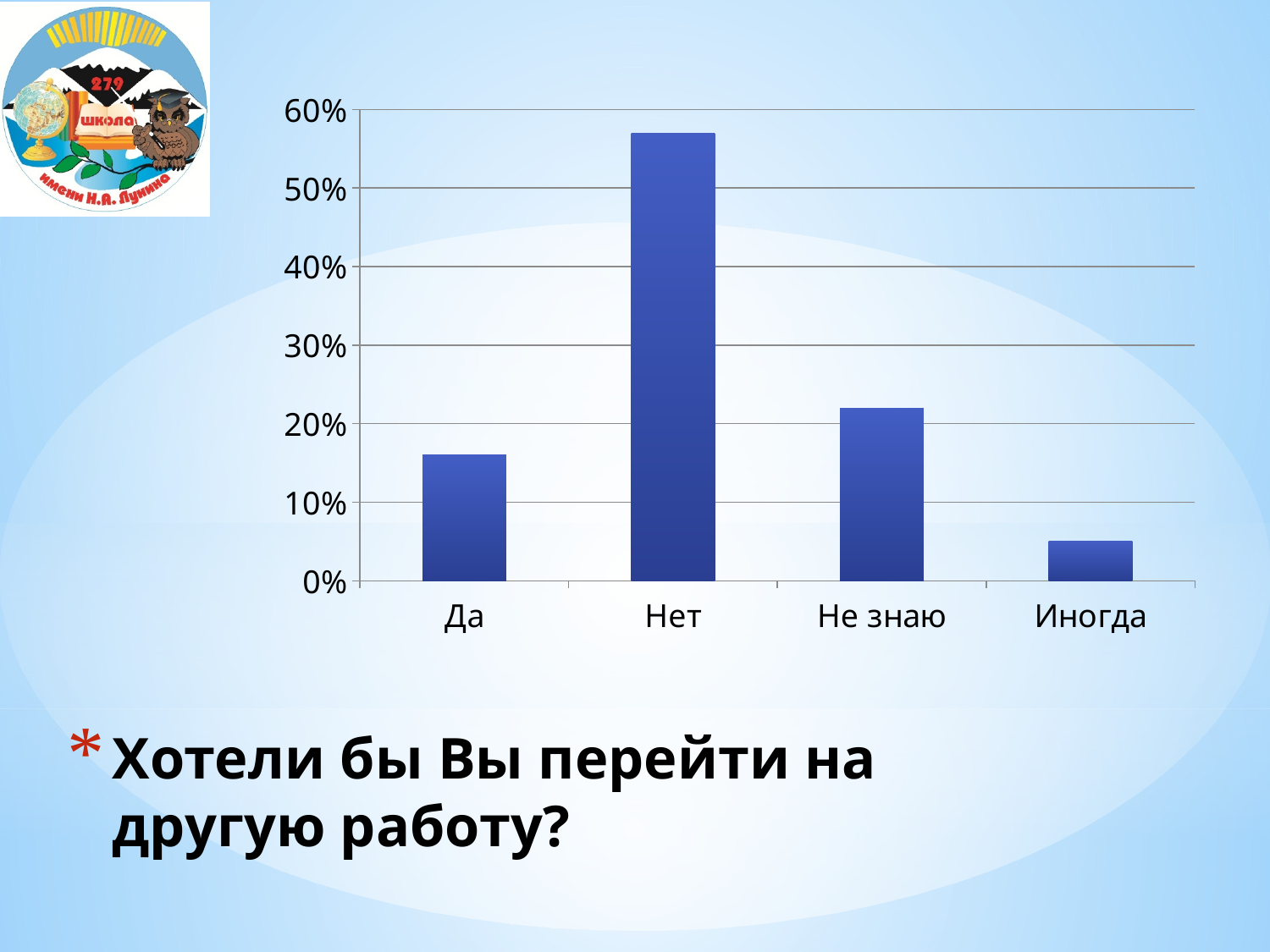
Is the value for Иногда greater or less than 10%? less Is the value for Нет greater or less than 50%? greater What question is the chart on the slide about, according to the text below it? Хотели бы Вы перейти на другую работу? Is the value for Да greater or less than 20%? less How many categories are shown on the x axis of the chart? 4 Which is larger, the value for Да or the value for Не знаю? Не знаю Which is larger, the value for Нет or the value for Иногда? Нет What kind of chart is shown on the slide? bar chart Which category has the lowest bar in the chart? Иногда What is the highest value shown on the y axis of the chart? 60% Which category has the highest bar in the chart? Нет